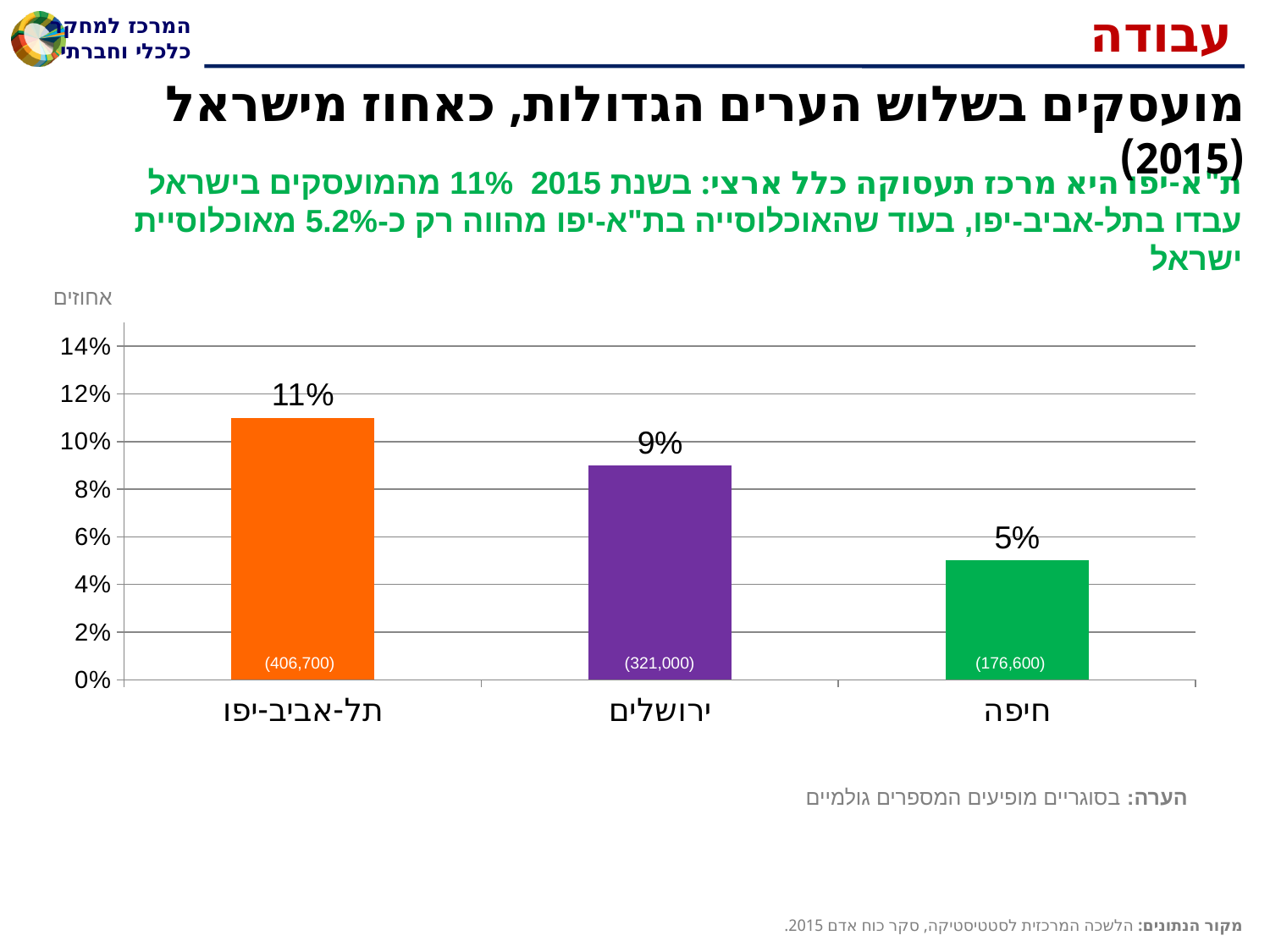
What type of chart is shown on the slide? Bar chart Which city has the highest share of employed persons in the chart? תל-אביב-יפו What value is shown for חיפה (Haifa) in the chart? 5% Which city has the lowest share of employed persons in the chart? חיפה How many cities are shown in the chart? 3 What value is shown for ירושלים (Jerusalem) in the chart? 9% Which has a larger share of employed persons, ירושלים (Jerusalem) or חיפה (Haifa)? ירושלים What is the difference in percentage points between תל-אביב-יפו (Tel Aviv-Yafo) and חיפה (Haifa)? 6% What absolute number is printed inside the bar for חיפה (Haifa)? 176,600 What absolute number is printed inside the bar for תל-אביב-יפו (Tel Aviv-Yafo)? 406,700 What is the label of the vertical axis of the chart? אחוזים What percentage of Israel's employed persons worked in תל-אביב-יפו (Tel Aviv-Yafo) according to the chart? 11%